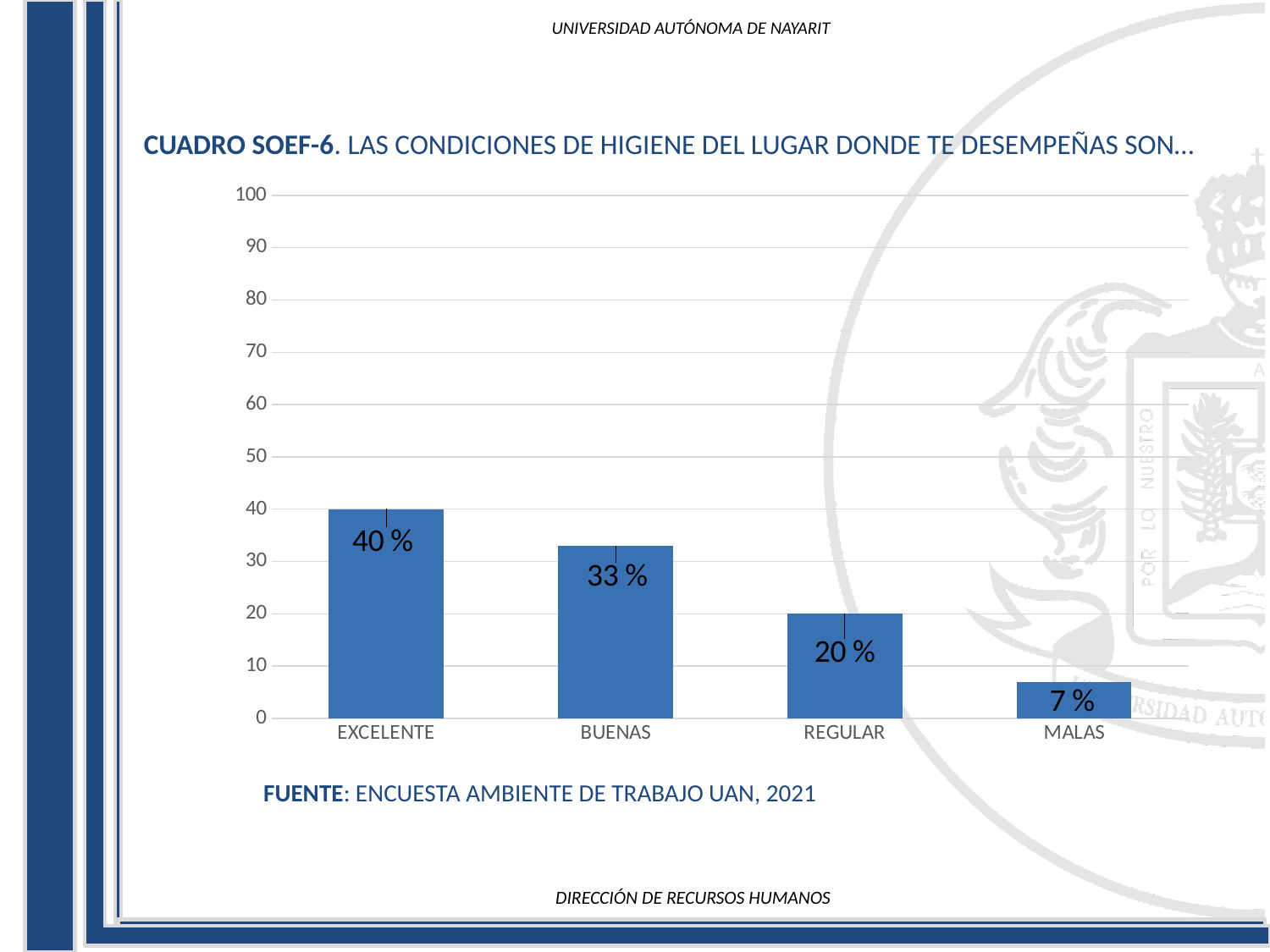
What kind of chart is shown on the slide? bar chart Which category has the lowest value? MALAS Which is larger, the value for REGULAR or the value for MALAS? REGULAR Which category has the highest value? EXCELENTE Do the values rise or fall from EXCELENTE to MALAS along the x axis? fall What is the value for MALAS? 7 % What is the difference between the values for EXCELENTE and BUENAS? 7 % How many categories are shown on the x axis? 4 What is the value for EXCELENTE? 40 % What is the value for REGULAR? 20 % Is the value for BUENAS greater or less than 30? greater What is the value for BUENAS? 33 %